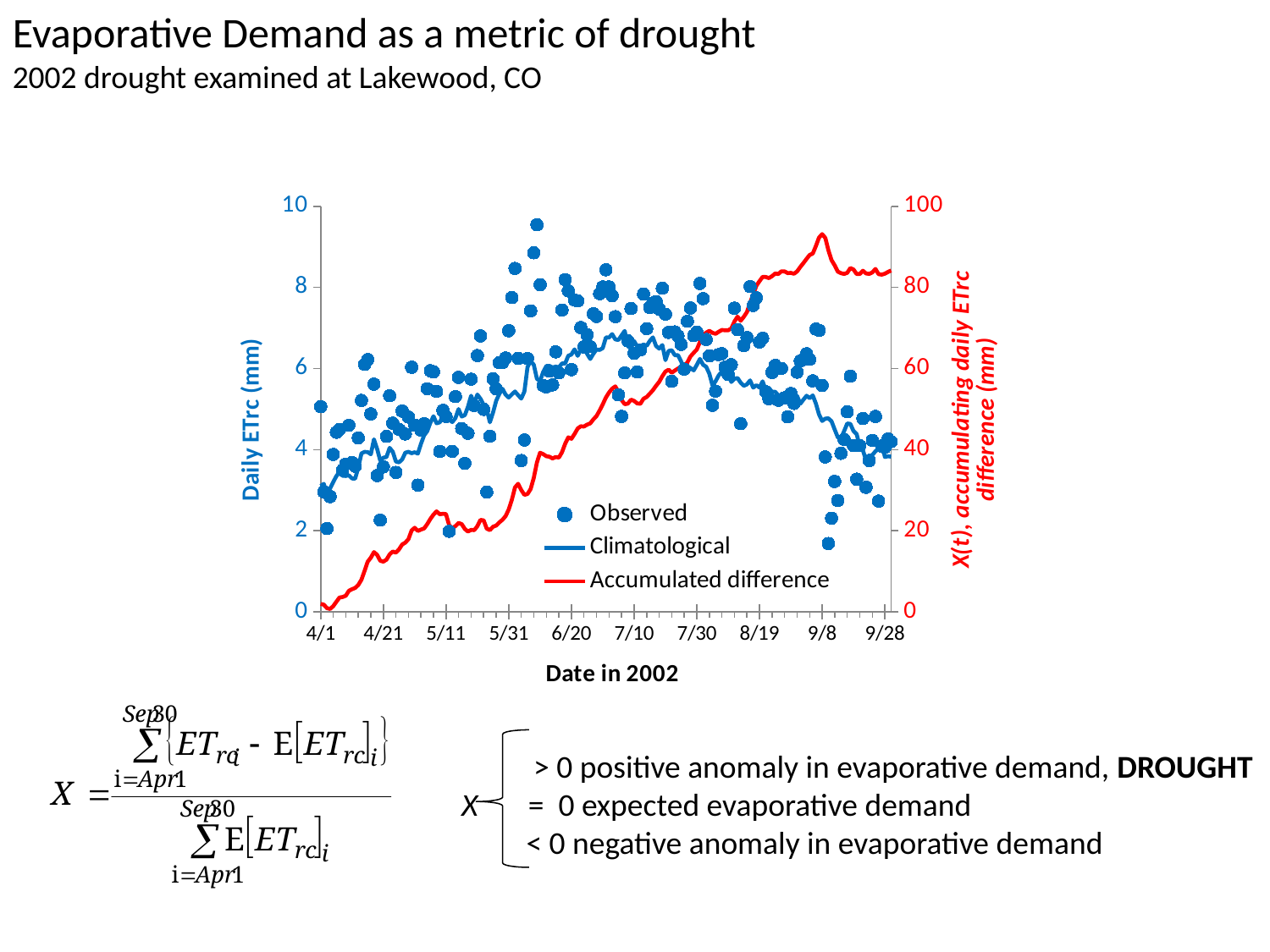
Is the highest Observed point on the chart greater or less than 8? greater How many date tick labels are shown on the x axis? 10 Does the Accumulated difference line generally rise or fall from 4/1 to 9/28? rise Is the Climatological value around 7/10 greater or less than 6? greater What are the three series named in the chart legend? Observed, Climatological, Accumulated difference How many series does the chart legend list? 3 Is the Accumulated difference value at its peak near 9/8 greater or less than 80? greater What is the title of the x axis of the chart? Date in 2002 Which series is drawn in red on the chart? Accumulated difference